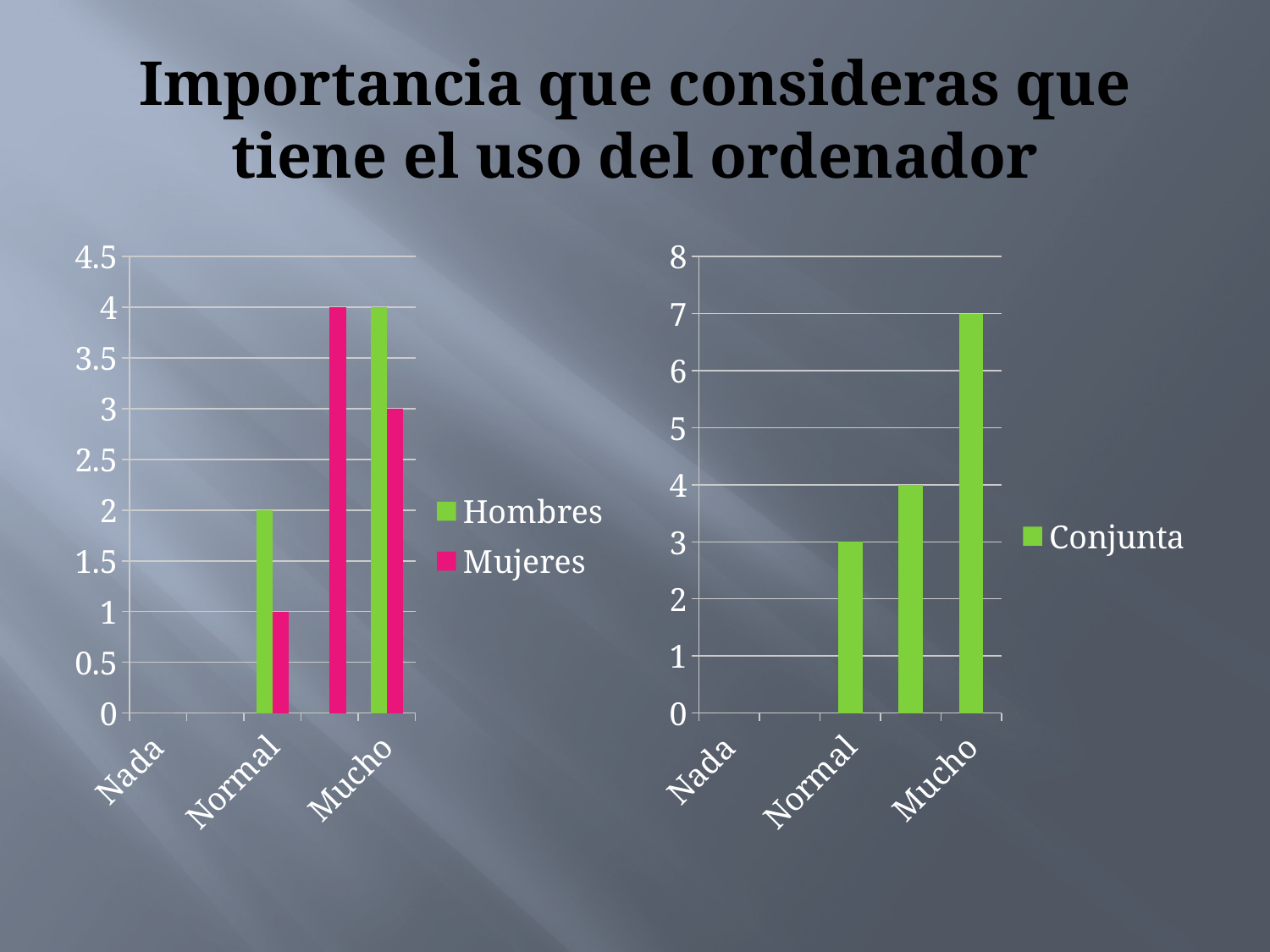
In the right chart (Conjunta), what is the difference between the values for Mucho and Normal? 4 In the right chart (Conjunta), which category has the highest value? Mucho How many series does the legend of the right chart list? 1 In the right chart (Conjunta), what is the value for Mucho? 7 How many series does the legend of the left chart list? 2 In the right chart (Conjunta), what is the value for Normal? 3 What kind of chart is the right chart (Conjunta)? Bar chart In the left chart (Hombres/Mujeres), what is the value for Hombres at Normal? 2 In the left chart, which series has the larger value at Normal, Hombres or Mujeres? Hombres In the left chart (Hombres/Mujeres), what is the value for Mujeres at Normal? 1 In the right chart (Conjunta), do the values rise or fall from Nada to Mucho? Rise